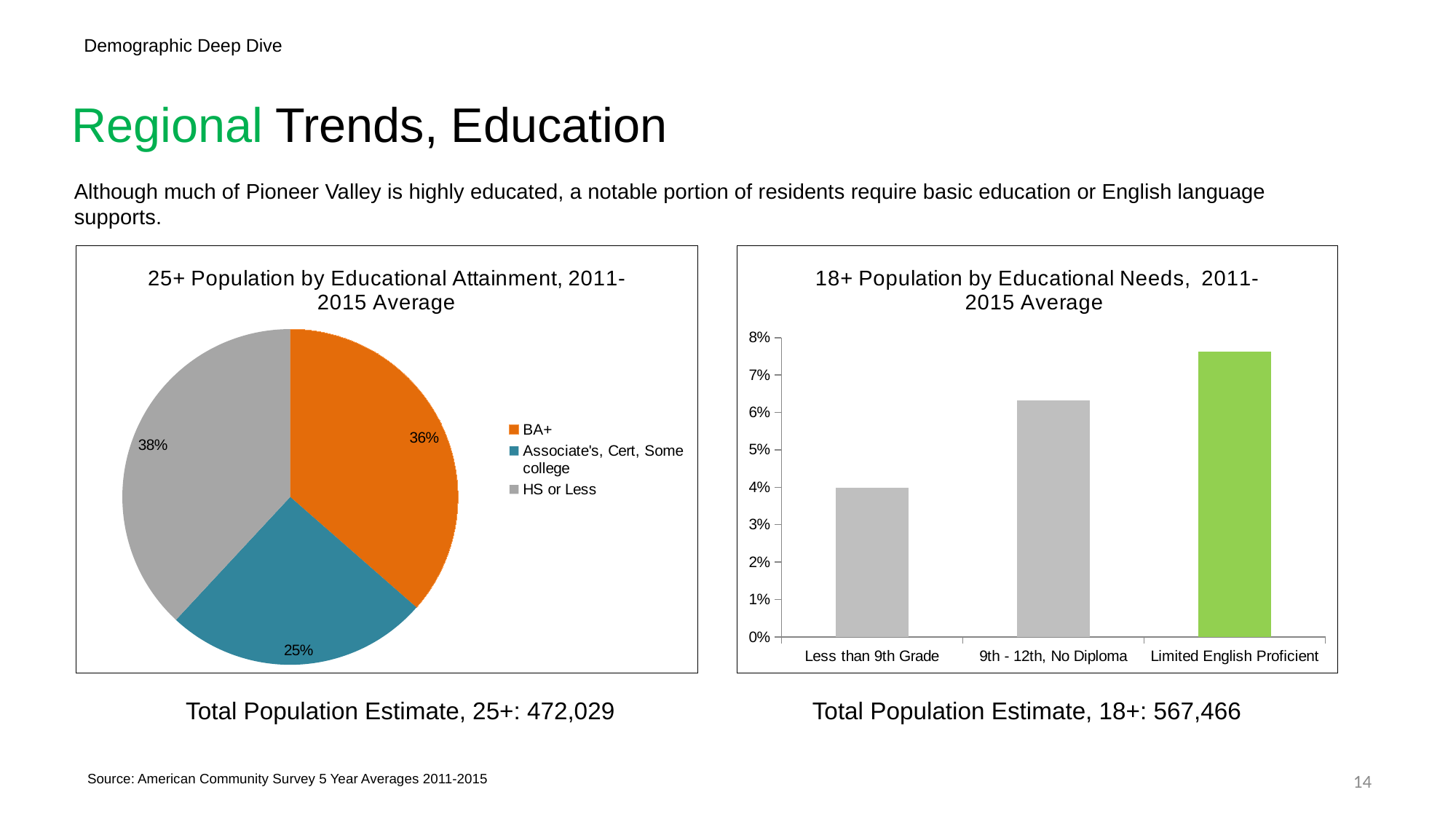
In the pie chart titled '25+ Population by Educational Attainment, 2011-2015 Average', what share is BA+? 36% In the pie chart on the left, which category has the largest share? HS or Less In the pie chart on the left, what share is 'Associate's, Cert, Some college'? 25% In the bar chart on the right, how many categories are shown on the x axis? 3 In the bar chart on the right, which category has the highest value? Limited English Proficient In the pie chart on the left, what is the difference in percentage points between 'HS or Less' and 'BA+'? 2 percentage points In the pie chart on the left, what share is 'HS or Less'? 38% What type of chart is the chart titled '18+ Population by Educational Needs, 2011-2015 Average'? Bar chart In the bar chart on the right, is the value for 'Less than 9th Grade' greater or less than 5%? less In the bar chart on the right, is the value for 'Limited English Proficient' greater or less than 7%? greater In the pie chart on the left, which category has the smallest share? Associate's, Cert, Some college In the pie chart on the left, how many categories does the legend list? 3